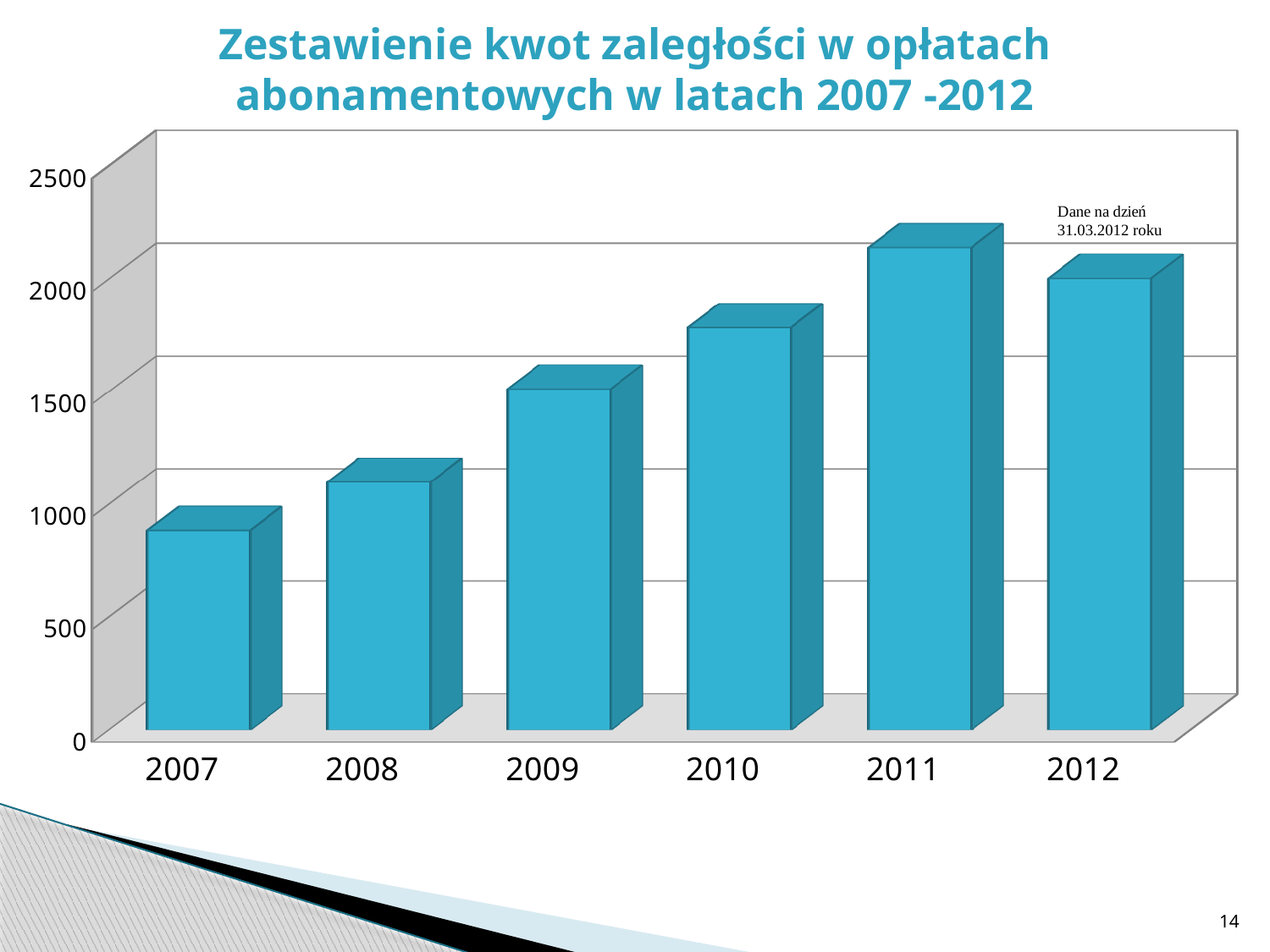
Is the value for 2011 greater or less than 2000? greater What date is given in the note on the chart ("Dane na dzień")? 31.03.2012 roku What kind of chart is shown on the slide? Bar chart Do the values rise or fall from 2007 to 2011? rise Is the value for 2007 greater or less than 1000? less Is the value for 2012 greater or less than 1500? greater Which year has the larger value, 2009 or 2010? 2010 How many years are shown on the x axis of the chart? 6 Which year has the lowest bar in the chart? 2007 Which year has the highest bar in the chart? 2011